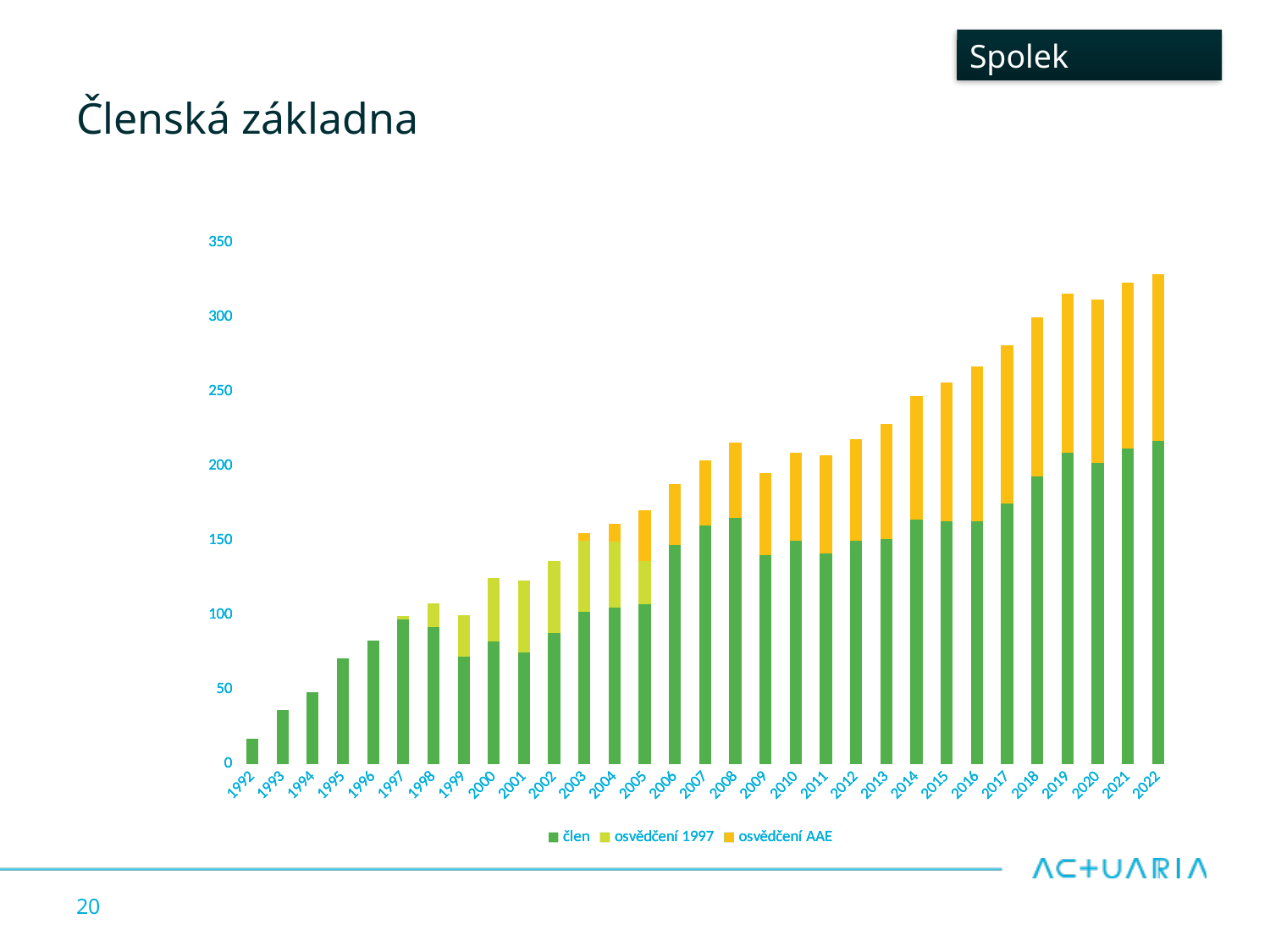
How many years are shown on the x axis of the chart? 31 Is the total value for 1992 greater or less than 50? less Do the total bar heights generally rise or fall from 1992 to 2022? rise Which year has the highest total bar in the chart? 2022 Which series is shown in orange in the chart? osvědčení AAE Which year has the lowest total bar in the chart? 1992 How many series does the chart legend list? 3 What is the title of the chart on the slide? Členská základna Which year has the larger total bar, 2008 or 2009? 2008 Is the total value for 2013 greater or less than 250? less What kind of chart is shown on the slide? stacked bar chart Is the total value for 2022 greater or less than 300? greater